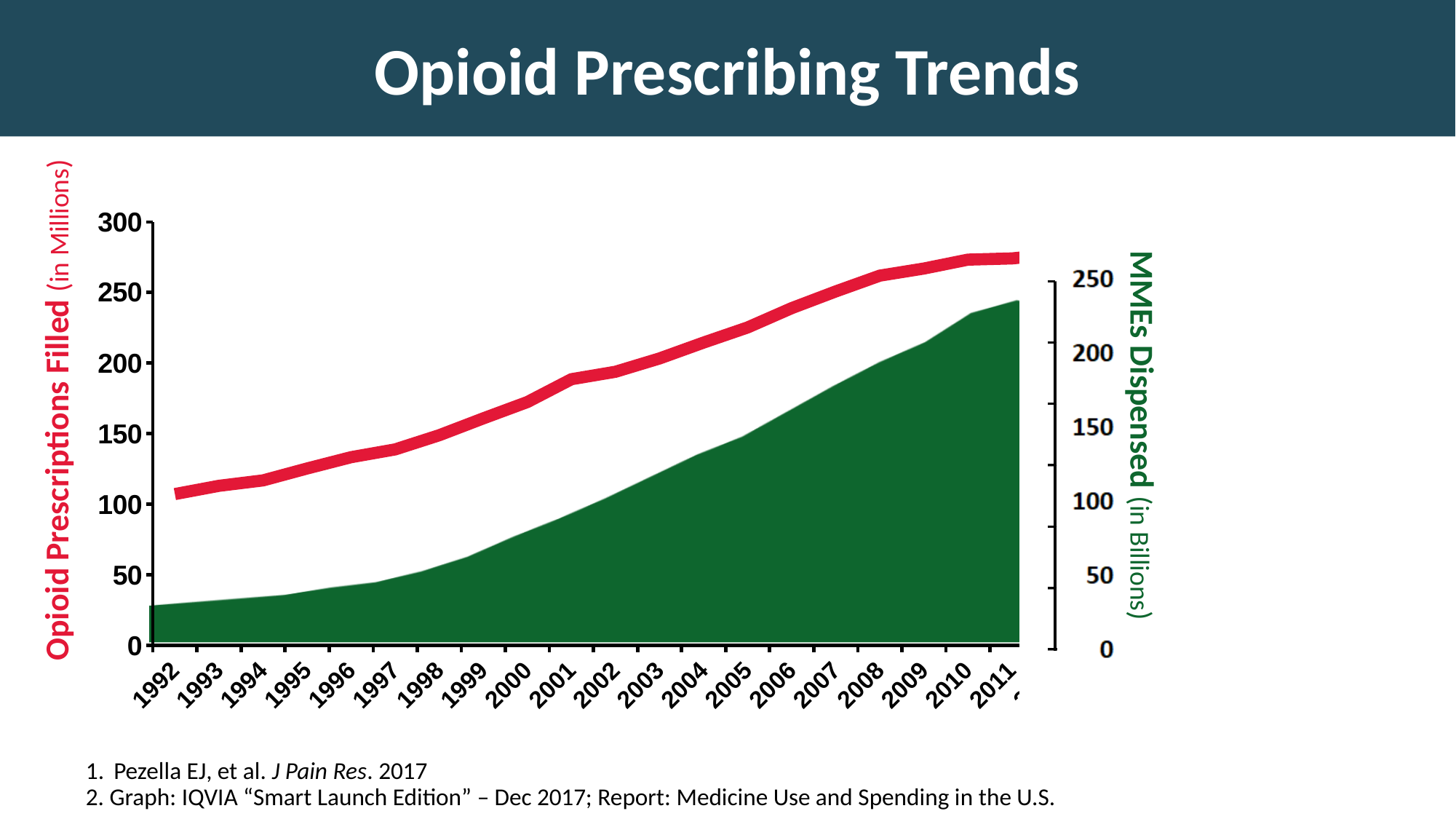
Is the value for Opioid Prescriptions Filled in 2011 greater or less than 250 million? greater What unit is used on the right-hand axis for MMEs Dispensed? Billions What is the last year shown on the x axis? 2011 Is the value for MMEs Dispensed in 1992 greater or less than 50 billion? less In which year is the value for MMEs Dispensed lowest? 1992 What kind of chart is shown on the slide? A combined line and area chart What is the title of the chart on the slide? Opioid Prescribing Trends Does the red line for Opioid Prescriptions Filled rise or fall from 1992 to 2011? Rise In which year is the value for Opioid Prescriptions Filled highest? 2011 What is the first year shown on the x axis? 1992 Does the green area for MMEs Dispensed rise or fall from 1992 to 2011? Rise How many years are shown along the x axis of the chart? 20